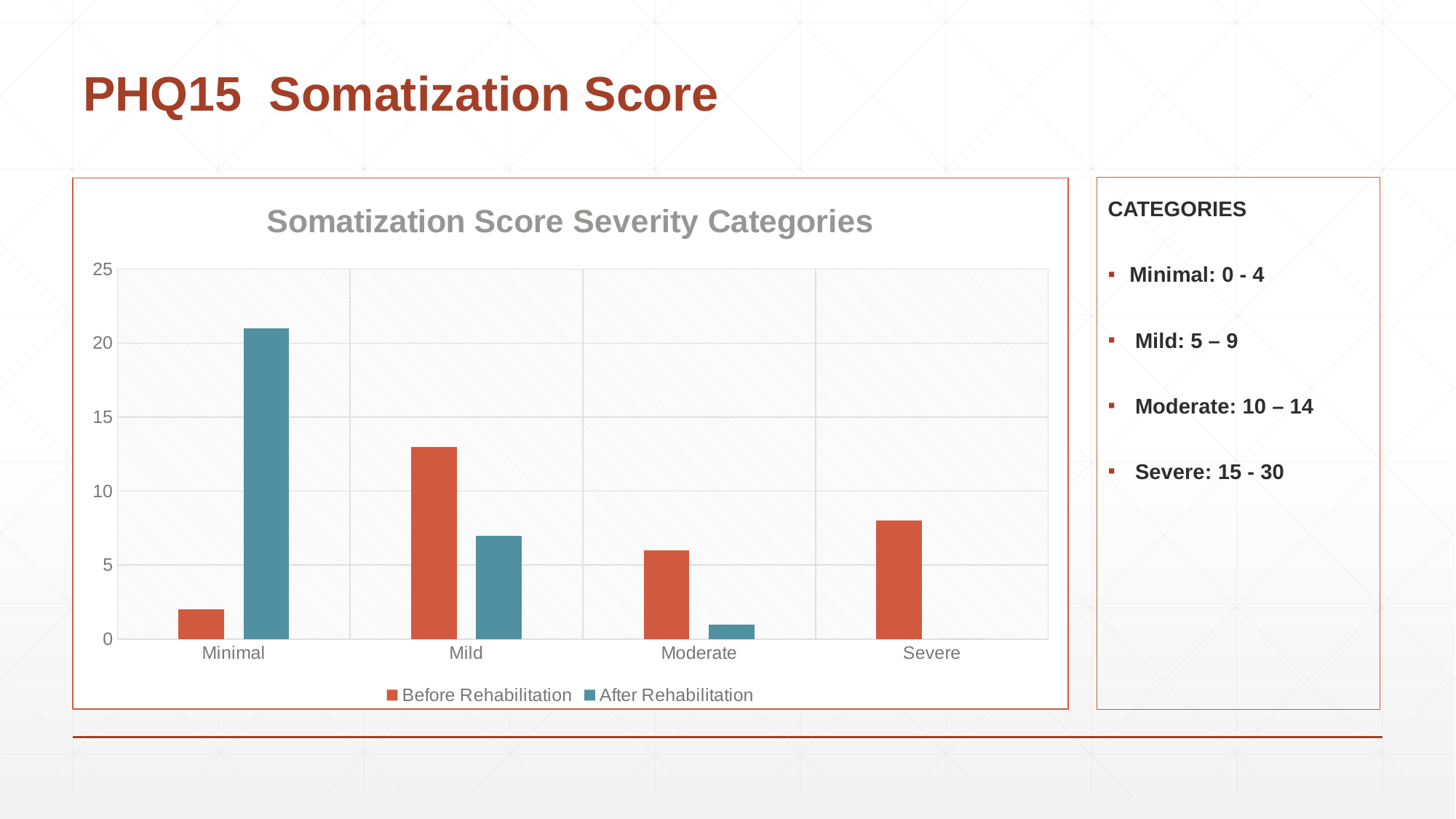
Is the Before Rehabilitation value for Moderate greater or less than 10? less Which category has the highest Before Rehabilitation value? Mild For the Mild category, which is larger: Before Rehabilitation or After Rehabilitation? Before Rehabilitation How many series does the chart's legend list? 2 What is the title of the chart? Somatization Score Severity Categories How many severity categories are shown on the x axis of the chart? 4 For the Minimal category, which is larger: Before Rehabilitation or After Rehabilitation? After Rehabilitation Is the Before Rehabilitation value for Mild greater or less than 10? greater Which category has the lowest Before Rehabilitation value? Minimal Which category has the highest After Rehabilitation value? Minimal Is the After Rehabilitation value for Minimal greater or less than 20? greater What kind of chart is shown on the slide? bar chart